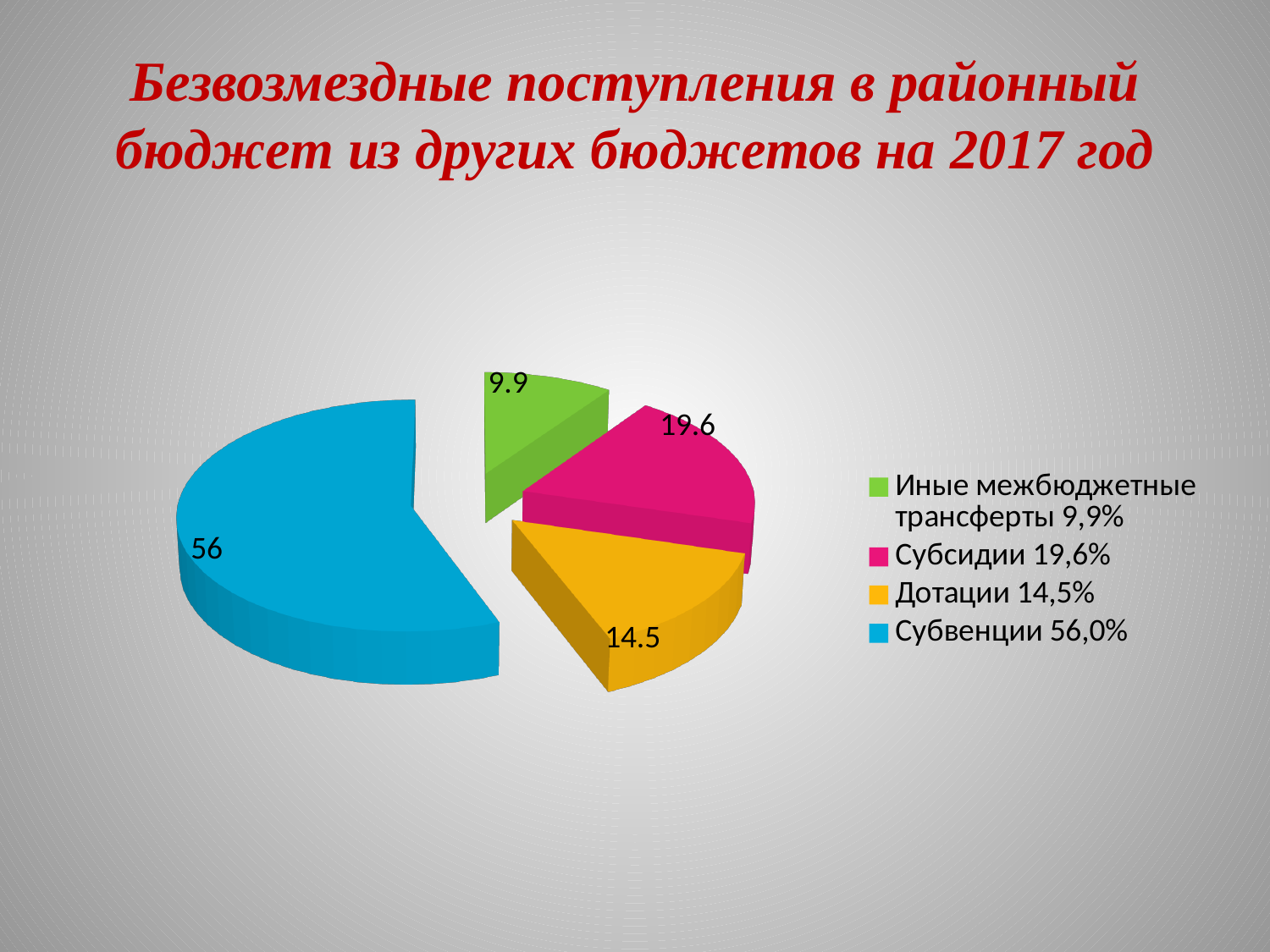
What kind of chart is shown on the slide? pie chart What is the value shown for Иные межбюджетные трансферты? 9.9 What is the difference between the values for Субвенции and Субсидии? 36.4 What colour is the slice for Субвенции? blue Which is larger, the value for Дотации or the value for Иные межбюджетные трансферты? Дотации What is the value shown for Субсидии? 19.6 What is the value shown for Дотации? 14.5 How many slices does the pie chart have? 4 Which category has the largest slice of the pie? Субвенции What is the difference between the values for Субсидии and Дотации? 5.1 What is the value shown for Субвенции? 56 Which category has the smallest slice of the pie? Иные межбюджетные трансферты